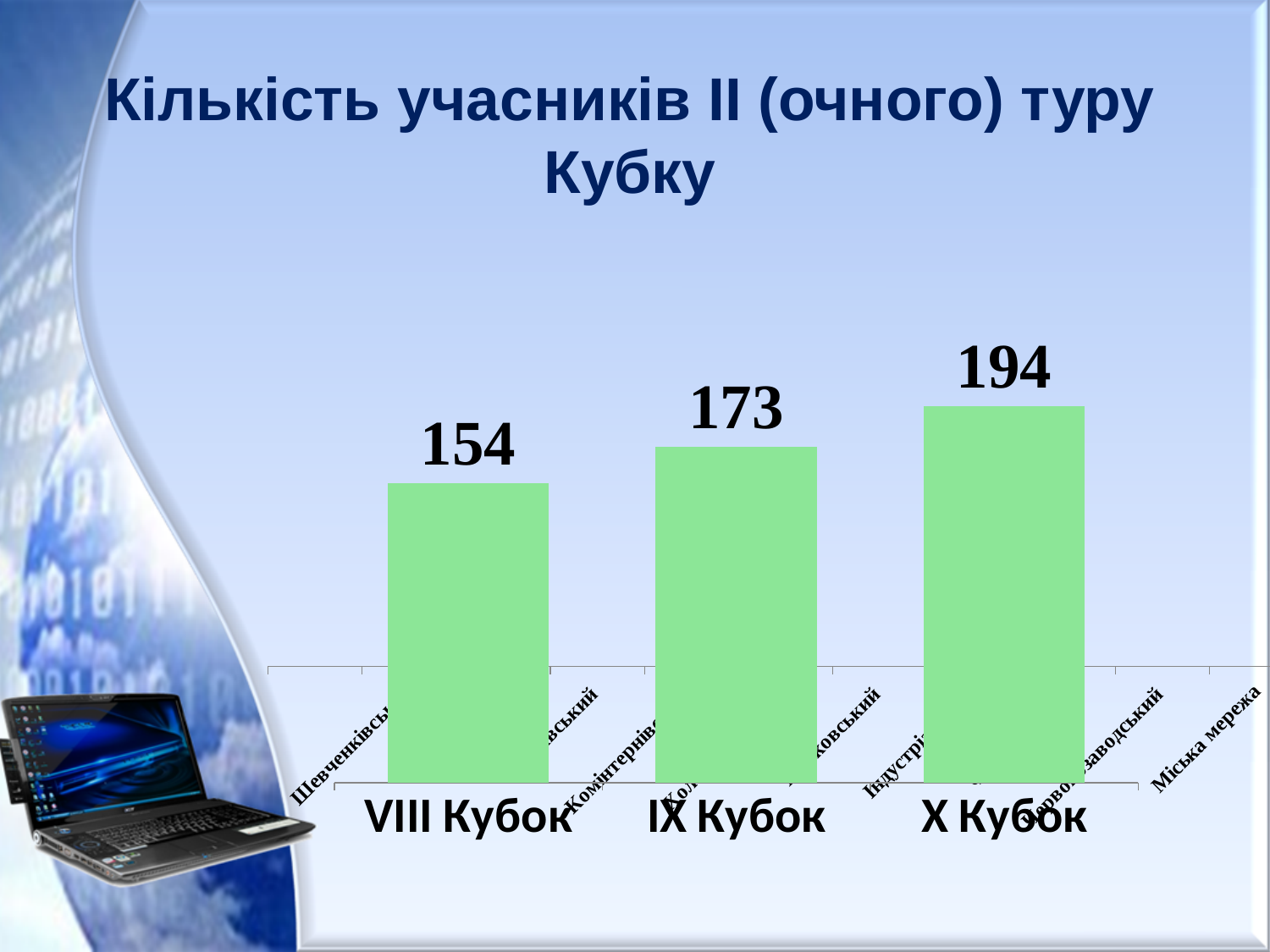
What is the value for IX Кубок? 173 What is the title of the slide's chart? Кількість учасників ІІ (очного) туру Кубку Which is larger, the value for IX Кубок or the value for X Кубок? X Кубок Which category has the highest value? X Кубок What is the difference between the values for X Кубок and VIII Кубок? 40 Which category has the lowest value? VIII Кубок What kind of chart is shown on the slide? bar chart What is the value for X Кубок? 194 What is the difference between the values for IX Кубок and VIII Кубок? 19 What is the value for VIII Кубок? 154 How many bars are shown in the chart? 3 Do the values rise or fall from VIII Кубок to X Кубок? rise